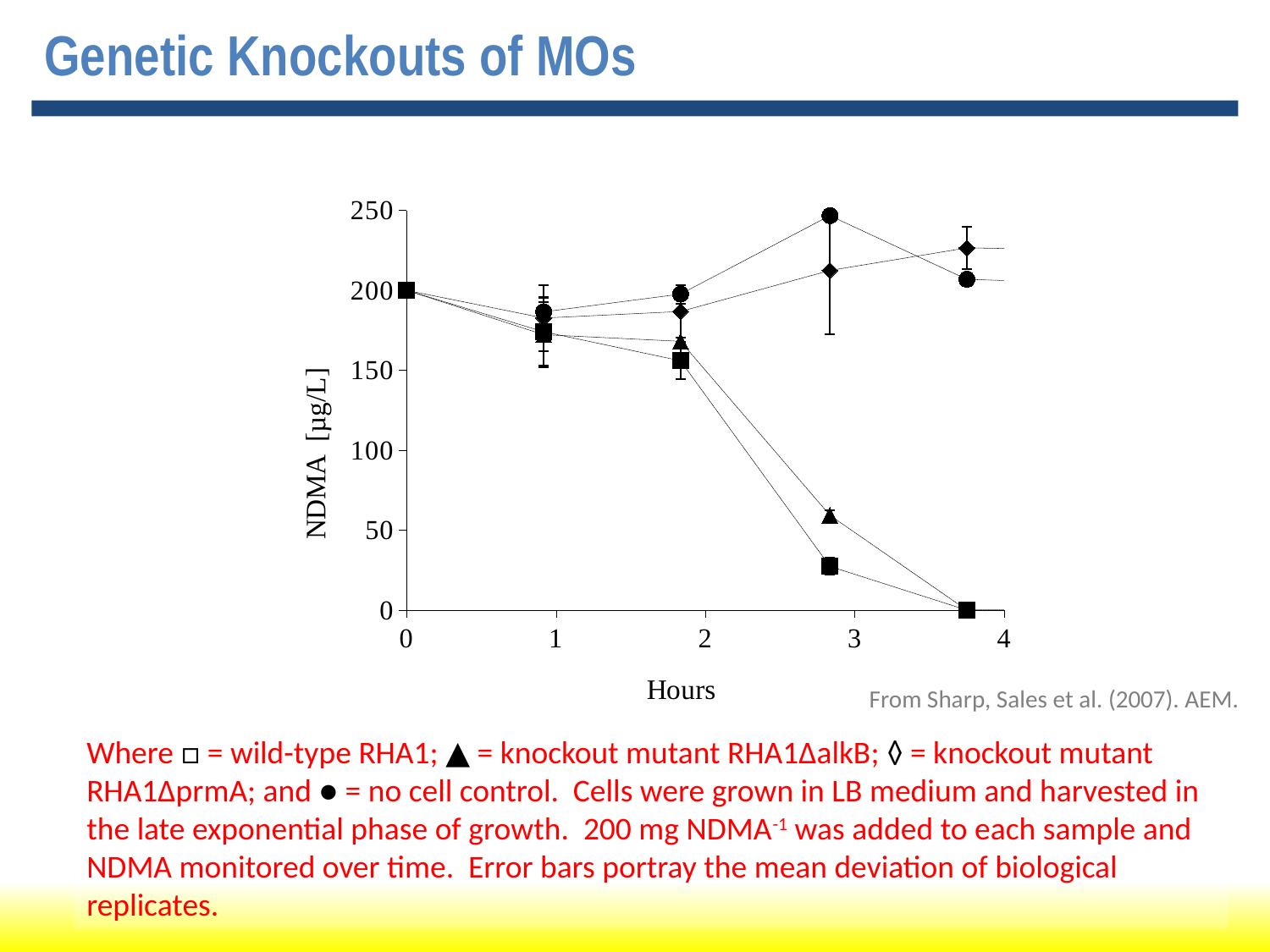
What is the label of the x-axis? Hours Is the NDMA value for knockout mutant RHA1ΔalkB (triangle markers) at about 2.8 hours greater or less than 100? less At about 2.8 hours, which is larger: the NDMA value for the no cell control or for wild-type RHA1? no cell control Is the NDMA value for the no cell control (circle markers) at about 2.8 hours greater or less than 200? greater How many data series are plotted on the chart? 4 What is the NDMA value for all series at 0 hours? 200 What kind of chart is shown on the slide? line chart What is the NDMA value for wild-type RHA1 (square markers) at the final time point, just under 4 hours? 0 What is the label of the y-axis? NDMA [µg/L] At about 2.8 hours, which series has the highest NDMA value? no cell control Is the NDMA value for wild-type RHA1 (square markers) at about 2.8 hours greater or less than 50? less Does the NDMA value for wild-type RHA1 (square markers) rise or fall over time? fall